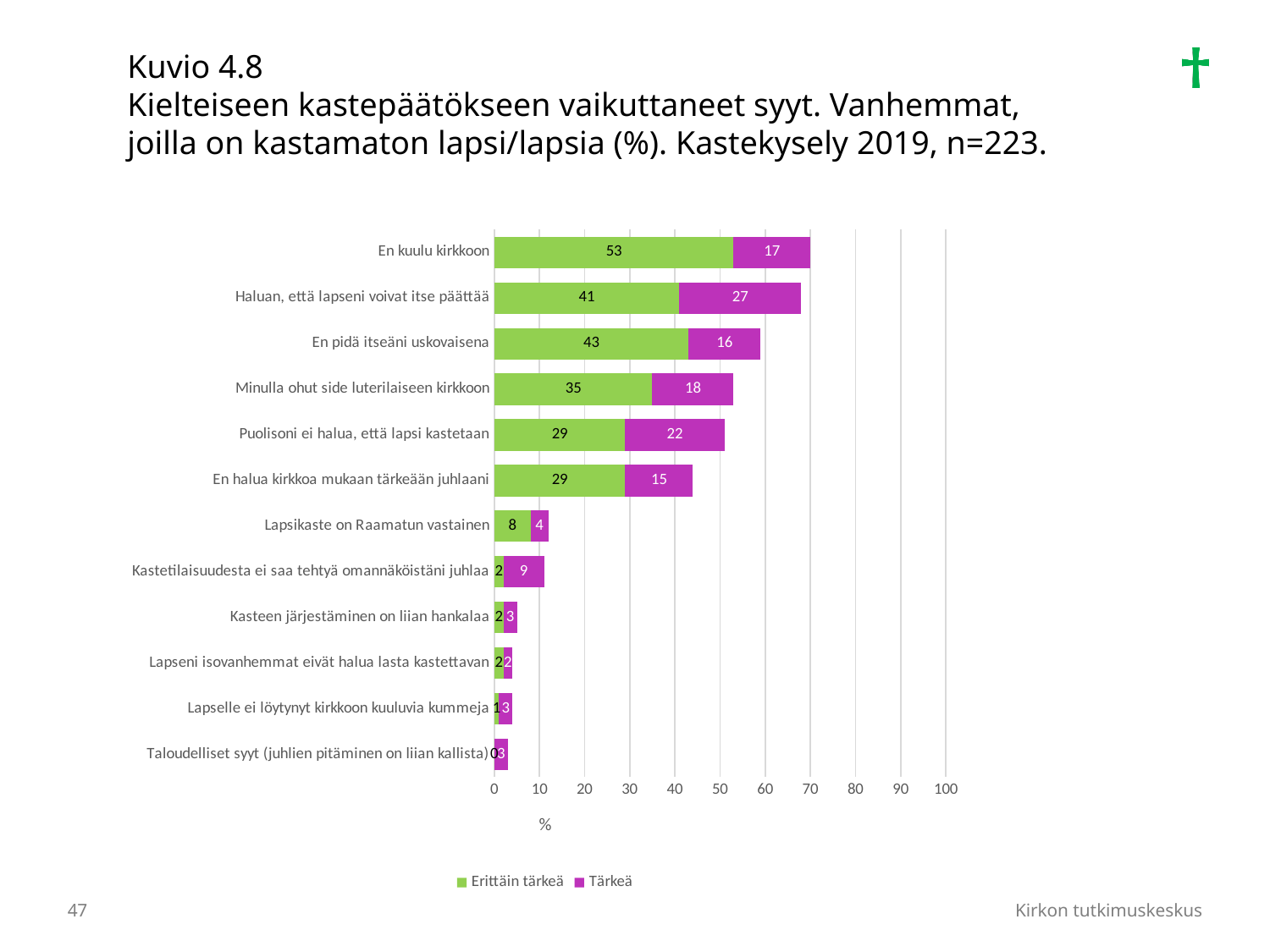
How many series does the legend list? 2 How many categories (reasons) are plotted in the chart? 12 What is the 'Erittäin tärkeä' value for 'En kuulu kirkkoon'? 53 What is the total of the stacked bar for 'En kuulu kirkkoon'? 70 Which category has the highest 'Tärkeä' value? Haluan, että lapseni voivat itse päättää What is the 'Tärkeä' value for 'Haluan, että lapseni voivat itse päättää'? 27 What is the total of the stacked bar for 'Puolisoni ei halua, että lapsi kastetaan'? 51 What is the difference between the 'Erittäin tärkeä' values for 'En pidä itseäni uskovaisena' and 'En halua kirkkoa mukaan tärkeään juhlaani'? 14 Which category has the highest 'Erittäin tärkeä' value? En kuulu kirkkoon What is the 'Erittäin tärkeä' value for 'Minulla ohut side luterilaiseen kirkkoon'? 35 What kind of chart is shown on the slide? Stacked bar chart Which is larger: the 'Tärkeä' value for 'Puolisoni ei halua, että lapsi kastetaan' or for 'En pidä itseäni uskovaisena'? Puolisoni ei halua, että lapsi kastetaan